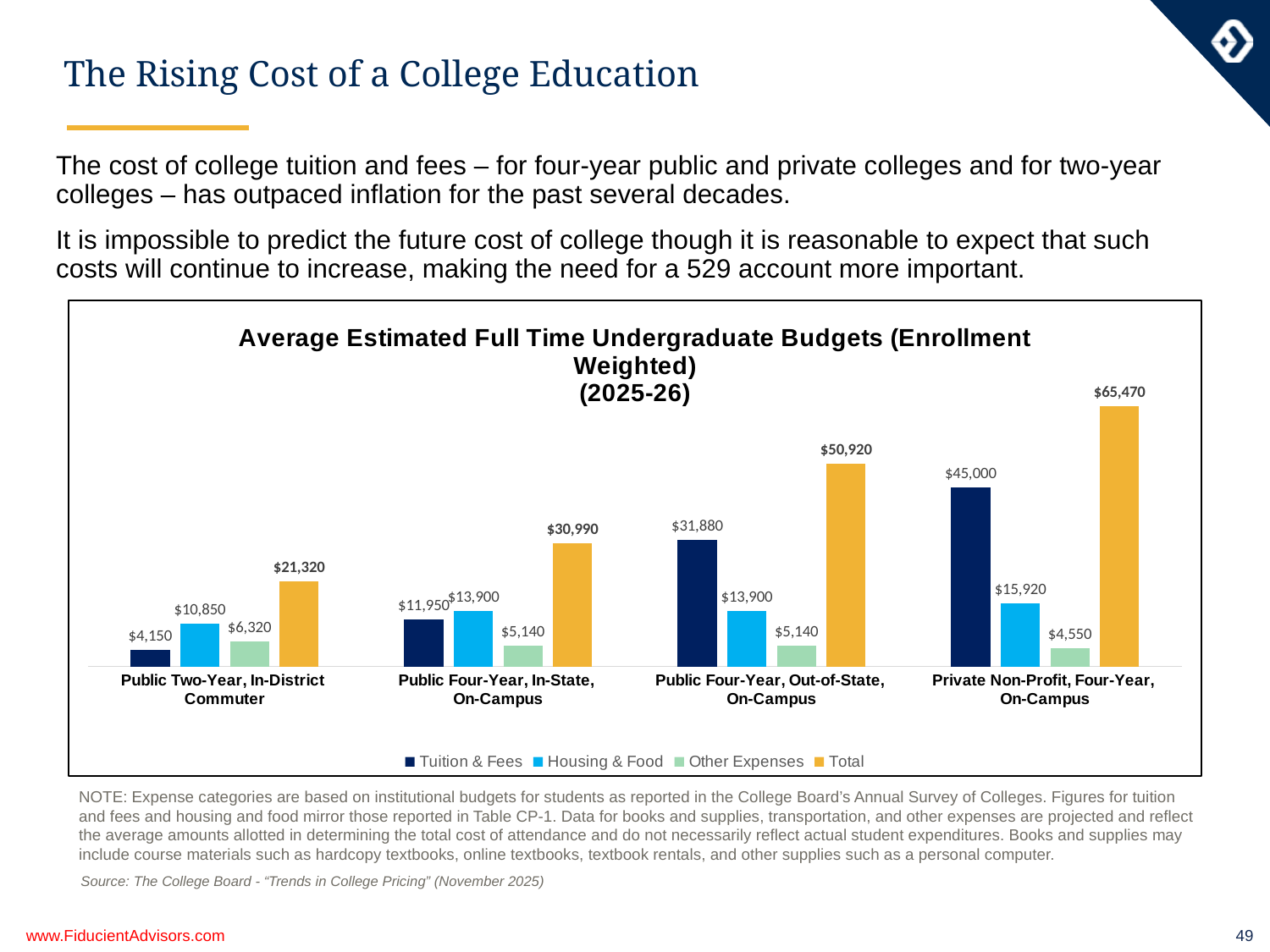
Which category has the lowest Tuition & Fees value? Public Two-Year, In-District Commuter What is the Total for Public Four-Year, Out-of-State, On-Campus? $50,920 What is the Other Expenses value for Public Four-Year, In-State, On-Campus? $5,140 Which category has the highest Total? Private Non-Profit, Four-Year, On-Campus What kind of chart is shown on the slide? Bar chart What is the Tuition & Fees value for Private Non-Profit, Four-Year, On-Campus? $45,000 How many categories are shown on the x axis? 4 How many series does the legend list? 4 What is the difference between the Total for Private Non-Profit, Four-Year, On-Campus and the Total for Public Four-Year, Out-of-State, On-Campus? $14,550 Which is larger: Tuition & Fees for Public Four-Year, Out-of-State, On-Campus or Tuition & Fees for Public Four-Year, In-State, On-Campus? Public Four-Year, Out-of-State, On-Campus What is the Housing & Food value for Public Two-Year, In-District Commuter? $10,850 Do the Total values rise or fall from left to right across the categories? Rise